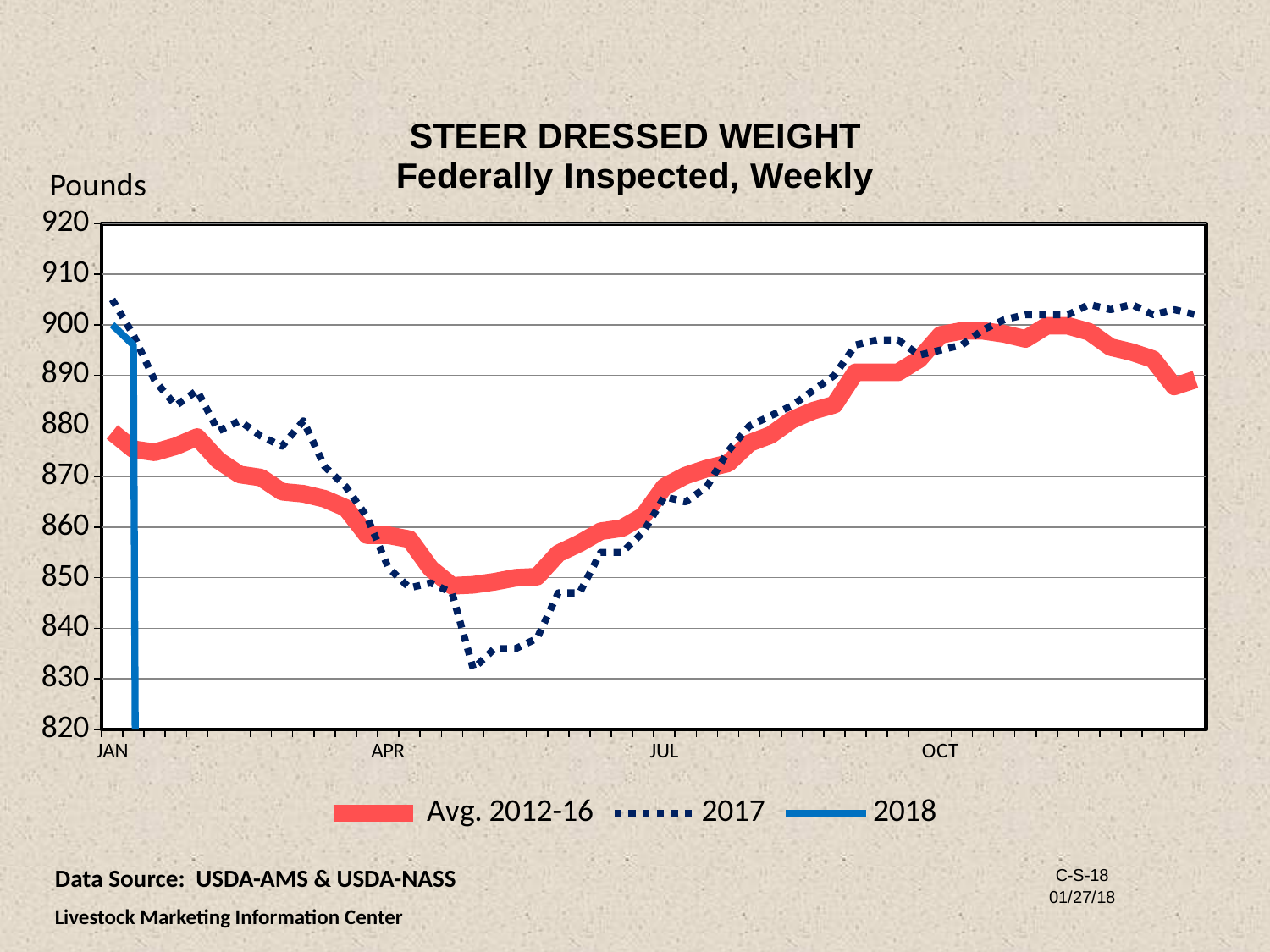
At the start of January, which is higher, the 2017 line or the Avg. 2012-16 line? 2017 Around May, which line reaches the lower value, 2017 or Avg. 2012-16? 2017 What kind of chart is shown on the slide? line chart How many series does the legend list? 3 Is the lowest point of the 2017 line greater or less than 840? less Does the Avg. 2012-16 line rise or fall from January to May? fall What are the three series named in the legend? Avg. 2012-16, 2017, 2018 Is the lowest point of the Avg. 2012-16 line greater or less than 840? greater Is the 2017 value at the start of January greater or less than 890? greater What unit is shown on the vertical axis? Pounds